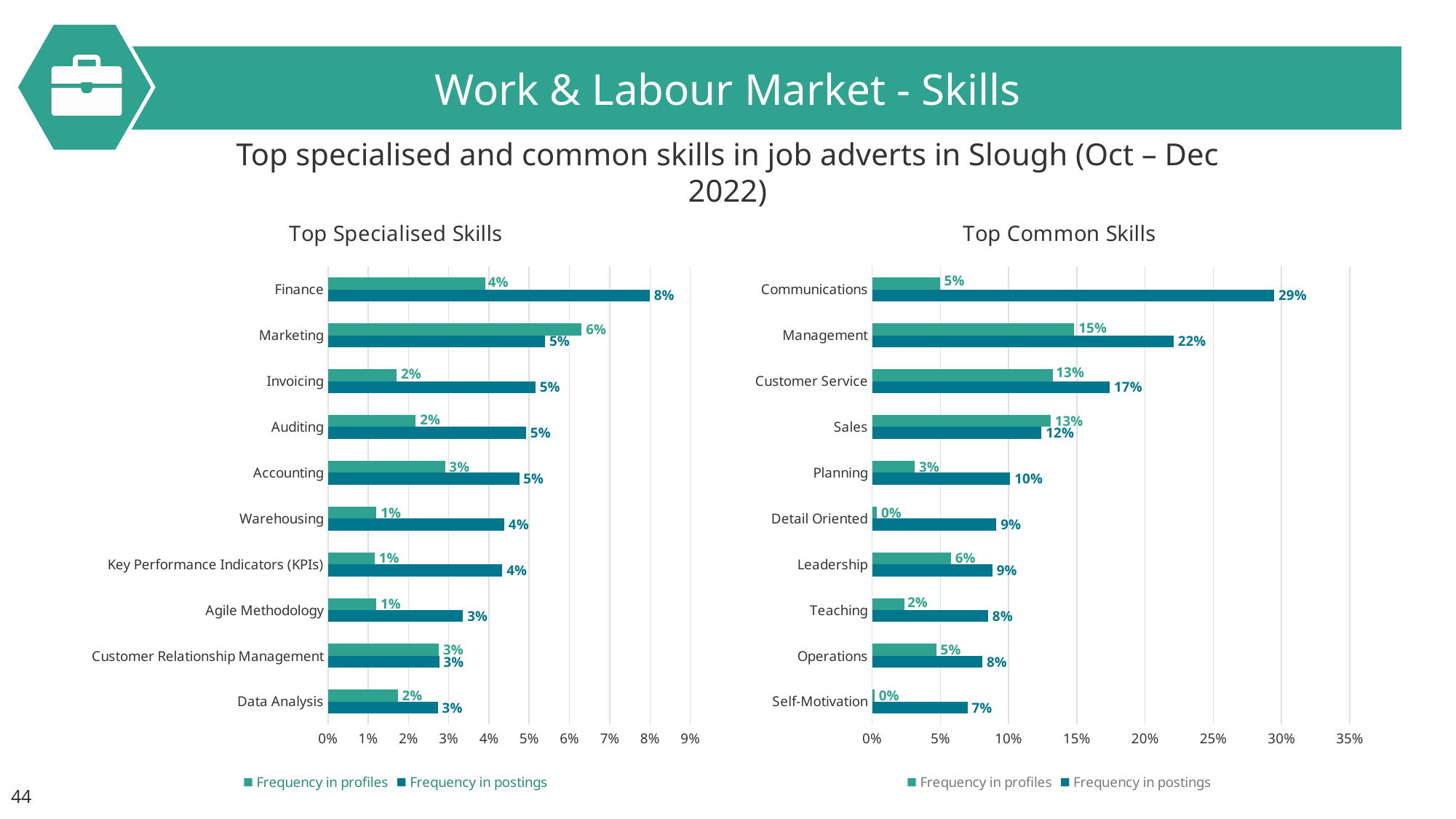
In the Top Common Skills chart, what is the Frequency in postings for Planning? 10% In the Top Common Skills chart, what is the Frequency in profiles for Management? 15% In the Top Specialised Skills chart, what is the Frequency in postings for Data Analysis? 3% In the Top Specialised Skills chart, which skill has the highest Frequency in profiles? Marketing In the Top Common Skills chart, what is the difference between Frequency in postings and Frequency in profiles for Communications? 24% In the Top Common Skills chart, which is larger for Sales: Frequency in profiles or Frequency in postings? Frequency in profiles In the Top Common Skills chart, which skill has the highest Frequency in postings? Communications In the Top Specialised Skills chart, how many skills are listed? 10 What is the title of the chart on the right side of the slide? Top Common Skills What type of chart is the Top Specialised Skills chart? Bar chart In the Top Specialised Skills chart, what is the Frequency in postings for Finance? 8% How many series does the legend of the Top Common Skills chart list? 2